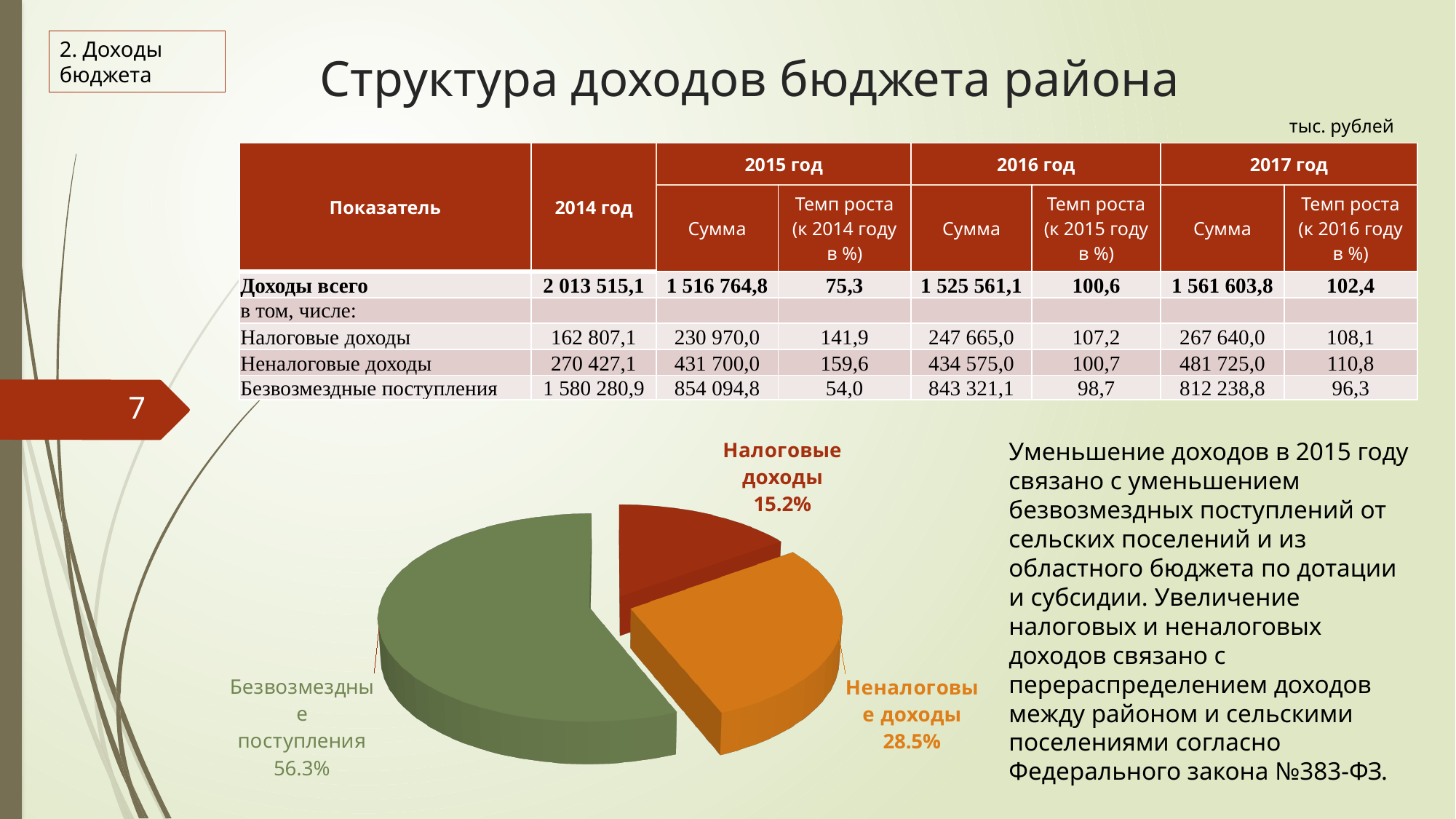
What share of the pie does Налоговые доходы have? 15.2% Which slice of the pie chart is the largest? Безвозмездные поступления Which is larger in the pie chart, Неналоговые доходы or Налоговые доходы? Неналоговые доходы What is the difference in percentage points between Безвозмездные поступления and Неналоговые доходы in the pie chart? 27.8 What is the difference in percentage points between Неналоговые доходы and Налоговые доходы in the pie chart? 13.3 What share of the pie does Безвозмездные поступления have? 56.3% What colour is the Неналоговые доходы slice in the pie chart? orange How many slices does the pie chart have? 3 What kind of chart is shown on the slide? pie chart What share of the pie does Неналоговые доходы have? 28.5% What colour is the Безвозмездные поступления slice in the pie chart? green Which slice of the pie chart is the smallest? Налоговые доходы